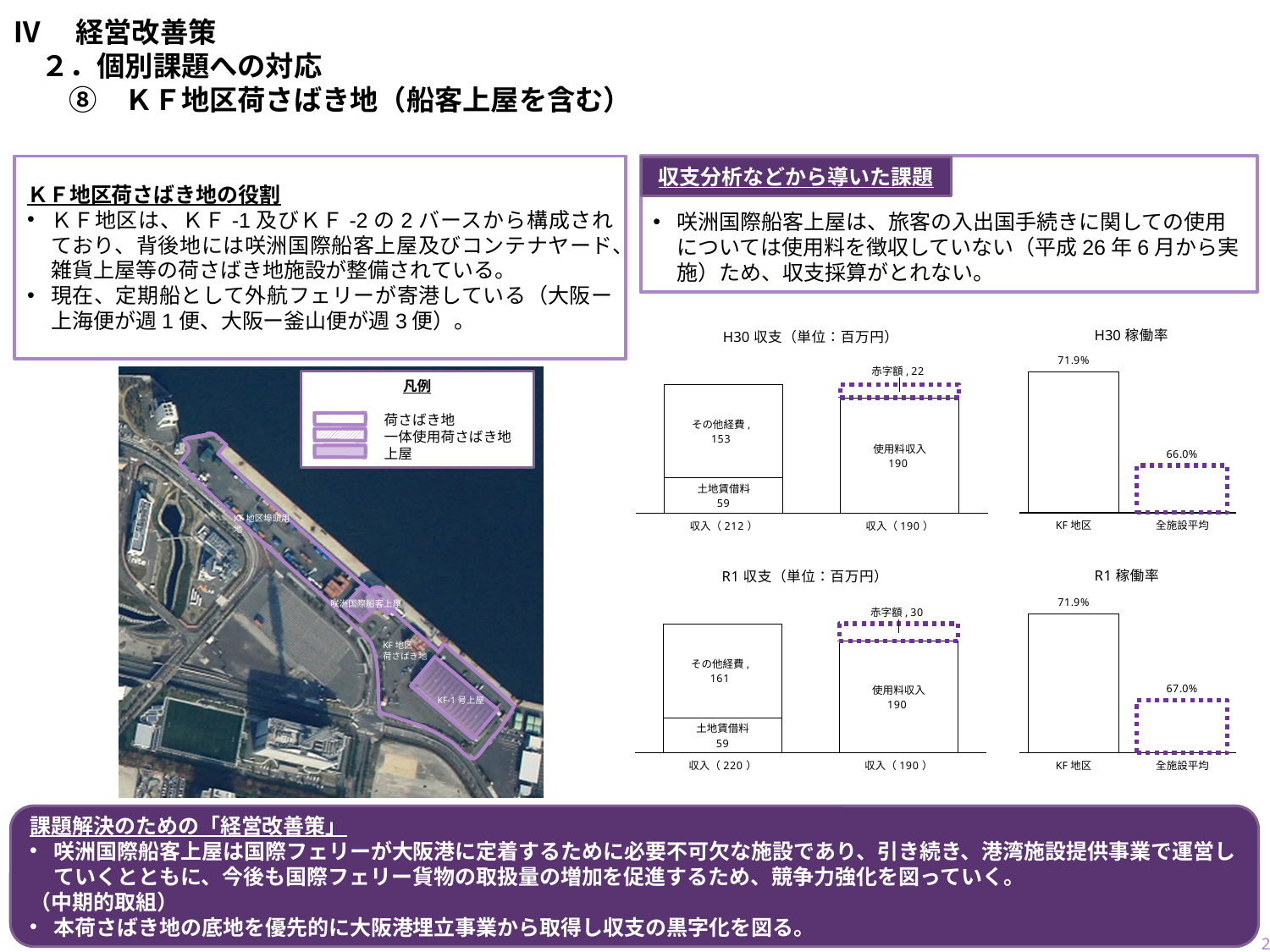
In the H30 収支 chart, what is the 赤字額? 22 In the R1 収支 chart, what is the difference between その他経費 and 土地賃借料? 102 In the R1 稼働率 chart, what is the value for 全施設平均? 67.0% In the H30 収支 chart, what is the value of 土地賃借料? 59 In the R1 収支 chart, what is the value of その他経費? 161 In the R1 稼働率 chart, what is the difference between KF地区 and 全施設平均? 4.9% In the H30 収支 chart, what is the total of the left stacked bar labelled 収入（212）? 212 In the H30 稼働率 chart, which category is higher, KF地区 or 全施設平均? KF地区 In the H30 稼働率 chart, what is the value for 全施設平均? 66.0% In the R1 収支 chart, what is the 赤字額? 30 In the H30 収支 chart, what is the value of その他経費? 153 In the H30 稼働率 chart, what is the value for KF地区? 71.9%